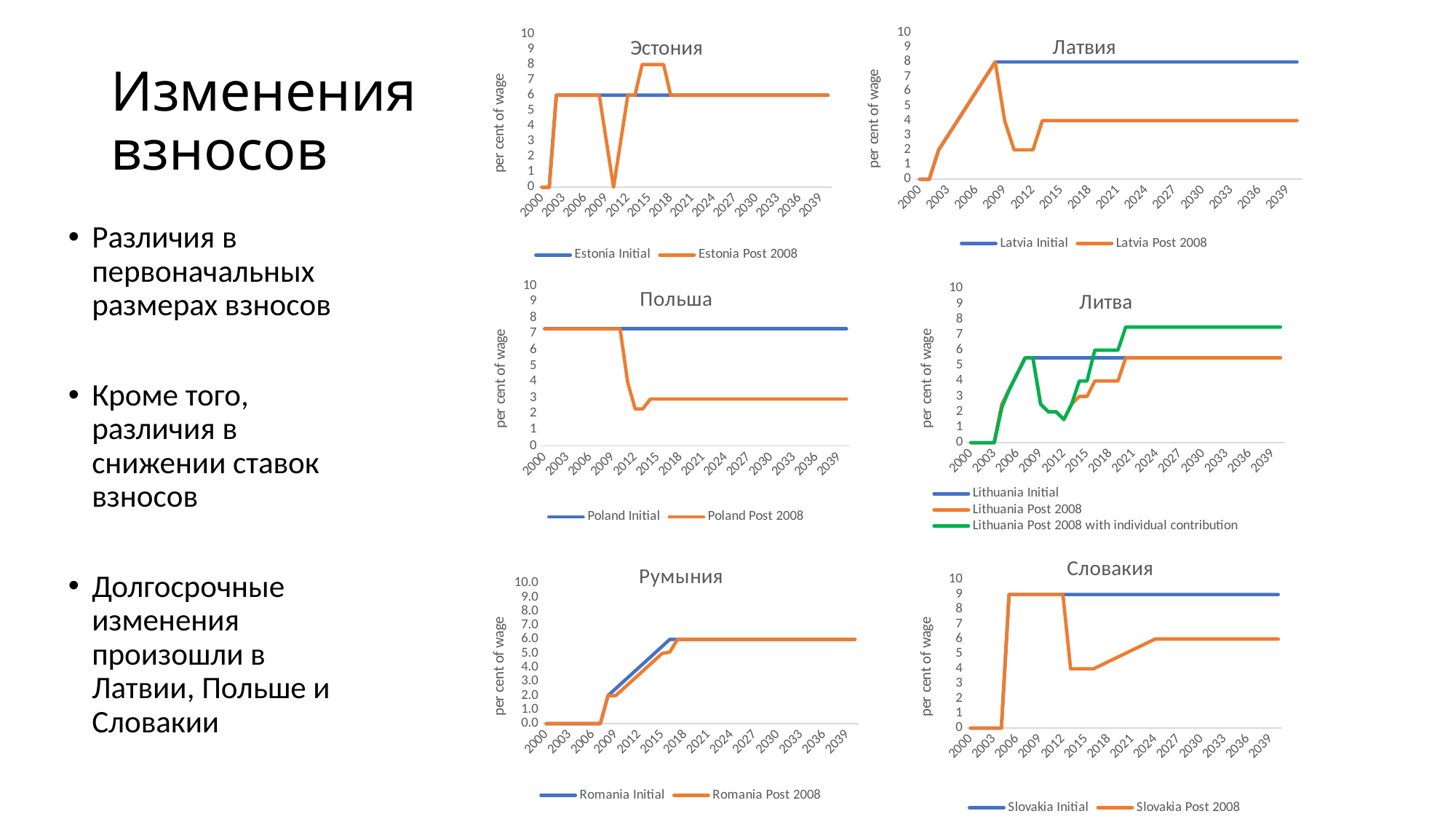
In the Словакия chart, what is the value of Slovakia Post 2008 in 2036? 6 In the Словакия chart, what is the value of Slovakia Initial in 2036? 9 In the Латвия chart, does Latvia Post 2008 rise or fall between 2009 and 2012? fall In the Латвия chart, what is the value of Latvia Post 2008 in 2030? 4 In the Латвия chart, what is the value of Latvia Initial in 2030? 8 How many charts are shown on the slide? 6 In the Литва chart, is the value of Lithuania Initial in 2030 greater or less than 5? greater How many series does the legend of the Латвия chart list? 2 How many series does the legend of the Литва chart list? 3 In the Польша chart, is the value of Poland Post 2008 in 2030 greater or less than 4? less What kind of chart is the Эстония chart? line chart What is the y-axis label of the Румыния chart? per cent of wage